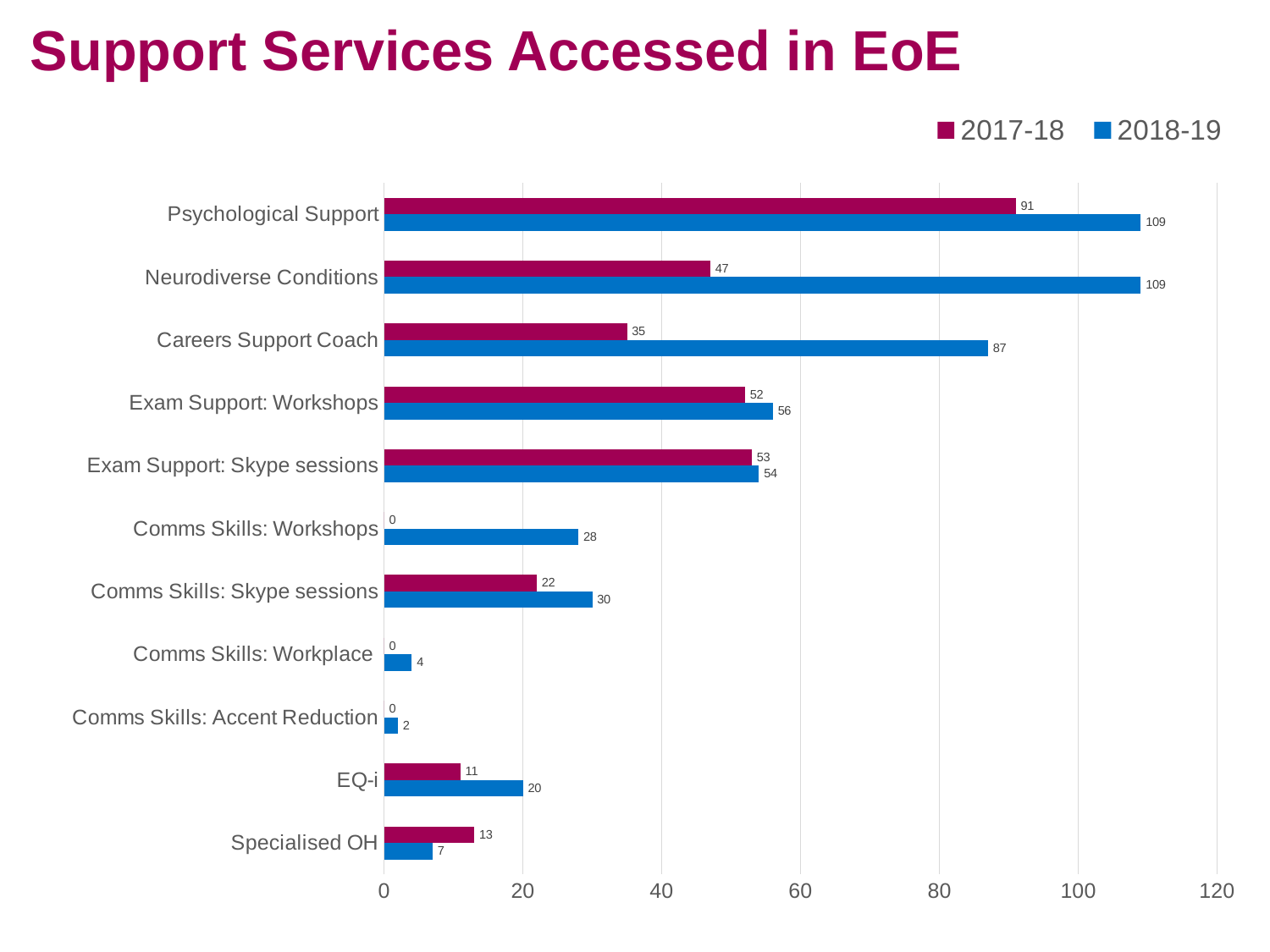
Is the 2018-19 value for Careers Support Coach greater or less than 80? greater What kind of chart is shown on the slide? Bar chart Which category had the lowest value in 2018-19? Comms Skills: Accent Reduction Which category had the highest value in 2017-18? Psychological Support What was the value for Psychological Support in 2018-19? 109 How many series does the legend list? 2 How many categories are shown on the chart? 11 What was the value for Comms Skills: Skype sessions in 2018-19? 30 What is the difference between the 2018-19 and 2017-18 values for Neurodiverse Conditions? 62 What was the value for Careers Support Coach in 2017-18? 35 Which was larger for Specialised OH: the 2017-18 value or the 2018-19 value? 2017-18 What is the title of the chart? Support Services Accessed in EoE